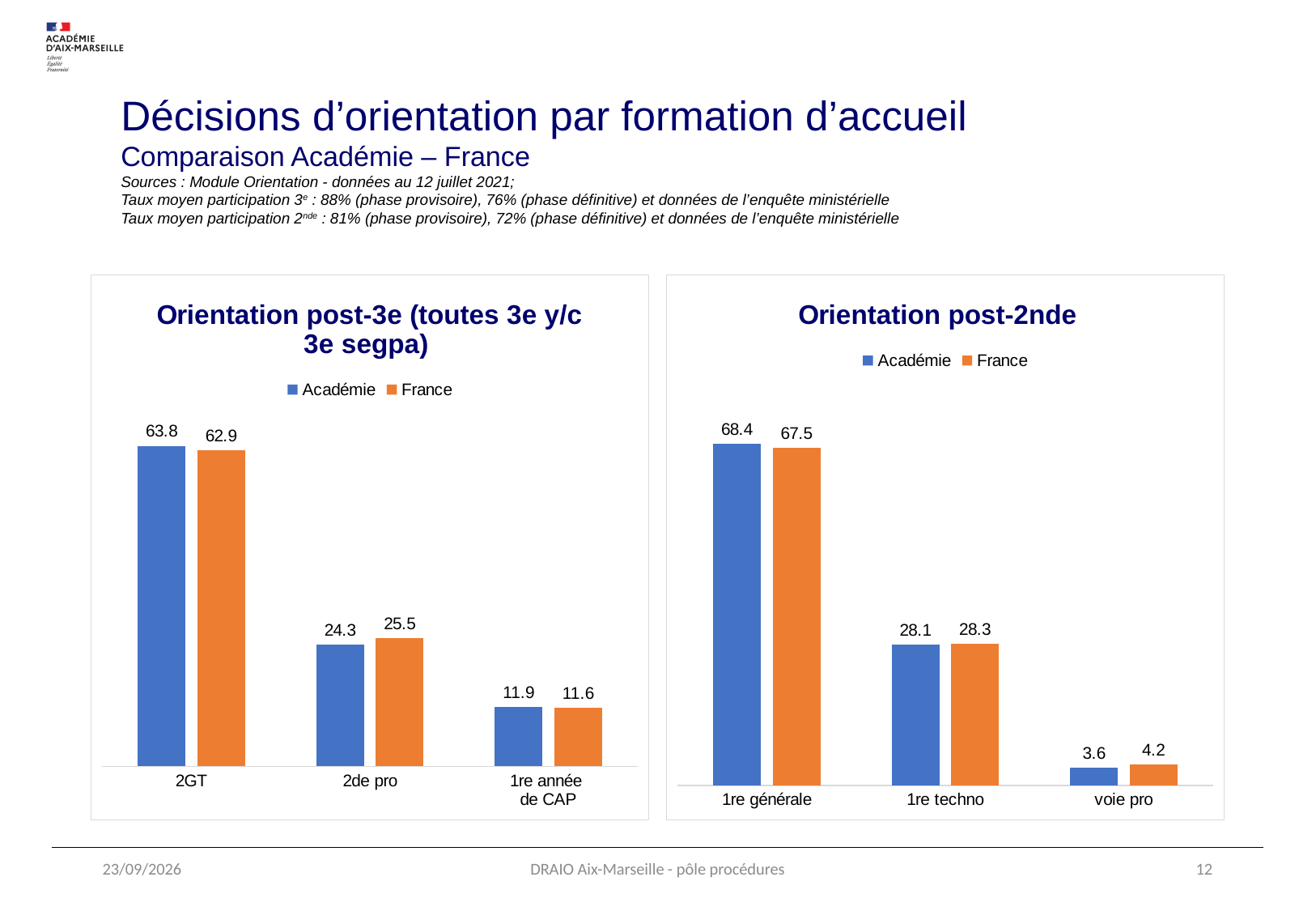
How many categories are shown in the 'Orientation post-2nde' chart? 3 In the 'Orientation post-3e' chart, what is the Académie value for 2GT? 63.8 In the 'Orientation post-2nde' chart, what is the France value for 1re générale? 67.5 In the 'Orientation post-2nde' chart, what is the difference between the France and Académie values for voie pro? 0.6 What type of chart is the 'Orientation post-2nde' chart? Bar chart In the 'Orientation post-3e' chart, what is the France value for 2de pro? 25.5 In the 'Orientation post-2nde' chart, what is the Académie value for voie pro? 3.6 How many series does the legend of the 'Orientation post-3e' chart list? 2 In the 'Orientation post-3e' chart, which is larger for 2de pro: Académie or France? France In the 'Orientation post-2nde' chart, which category has the lowest France value? voie pro In the 'Orientation post-3e' chart, which category has the highest Académie value? 2GT In the 'Orientation post-3e' chart, what is the difference between the Académie and France values for 2GT? 0.9